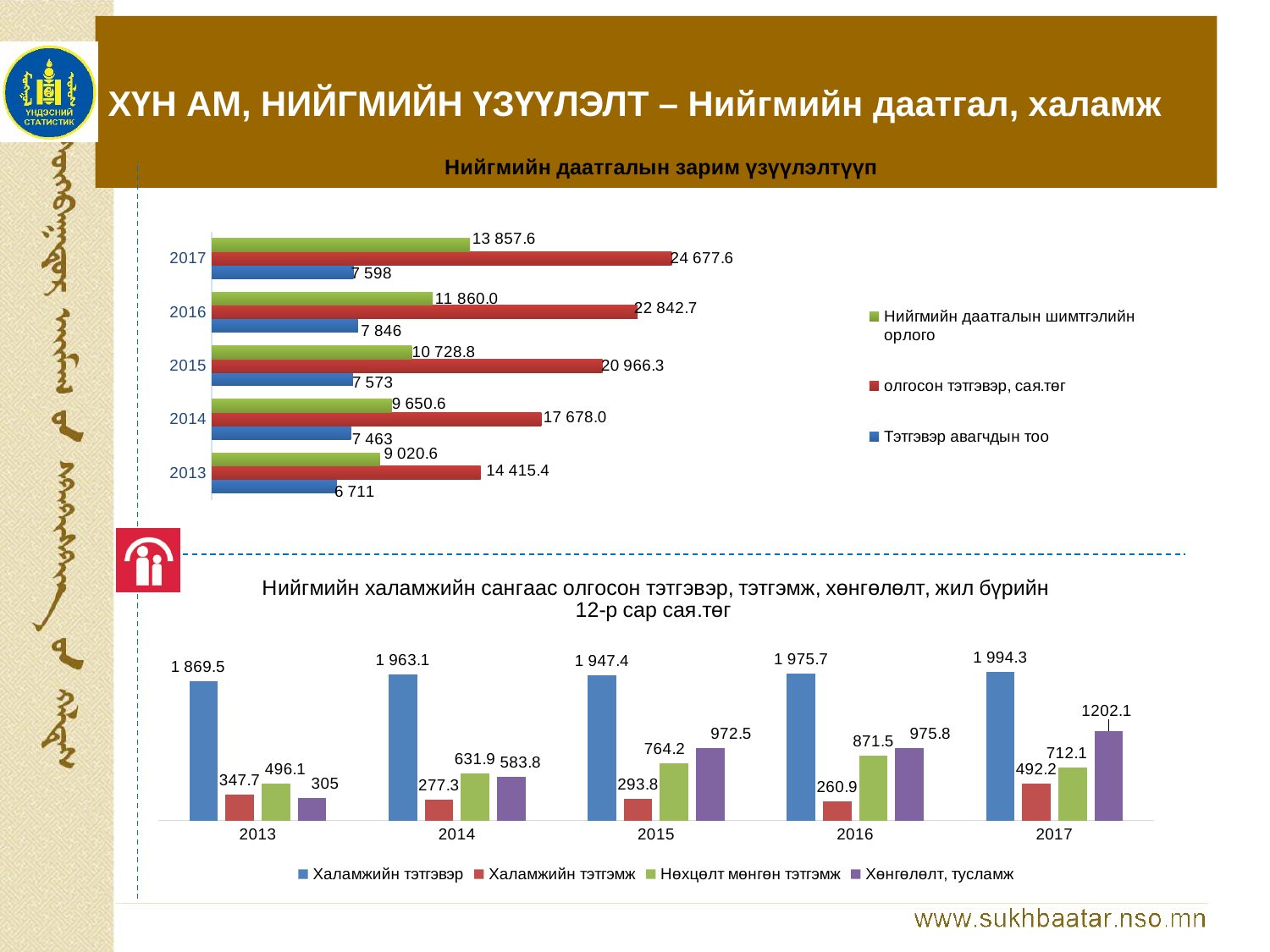
In the top chart (Нийгмийн даатгалын зарим үзүүлэлтүүп), what is the difference between Тэтгэвэр авагчдын тоо in 2016 and in 2015? 273 In the bottom chart (Нийгмийн халамжийн сангаас олгосон тэтгэвэр...), what is the value of Хөнгөлөлт, тусламж for 2017? 1202.1 In the bottom chart (Нийгмийн халамжийн сангаас олгосон тэтгэвэр...), which year has the lowest value for Хөнгөлөлт, тусламж? 2013 In the top chart (Нийгмийн даатгалын зарим үзүүлэлтүүп), what is the value of Тэтгэвэр авагчдын тоо for 2013? 6 711 What type of chart is the bottom chart (Нийгмийн халамжийн сангаас олгосон тэтгэвэр...)? bar chart In the bottom chart (Нийгмийн халамжийн сангаас олгосон тэтгэвэр...), how many years are shown on the x axis? 5 In the top chart (Нийгмийн даатгалын зарим үзүүлэлтүүп), how many series does the legend list? 3 In the top chart (Нийгмийн даатгалын зарим үзүүлэлтүүп), which year has the highest value for Нийгмийн даатгалын шимтгэлийн орлого? 2017 In the top chart (Нийгмийн даатгалын зарим үзүүлэлтүүп), what is the value of олгосон тэтгэвэр, сая.төг for 2017? 24 677.6 In the bottom chart (Нийгмийн халамжийн сангаас олгосон тэтгэвэр...), what is the value of Халамжийн тэтгэмж for 2014? 277.3 In the bottom chart (Нийгмийн халамжийн сангаас олгосон тэтгэвэр...), which is larger in 2015: Нөхцөлт мөнгөн тэтгэмж or Хөнгөлөлт, тусламж? Хөнгөлөлт, тусламж In the top chart (Нийгмийн даатгалын зарим үзүүлэлтүүп), does the value of олгосон тэтгэвэр, сая.төг rise or fall from 2013 to 2017? rise